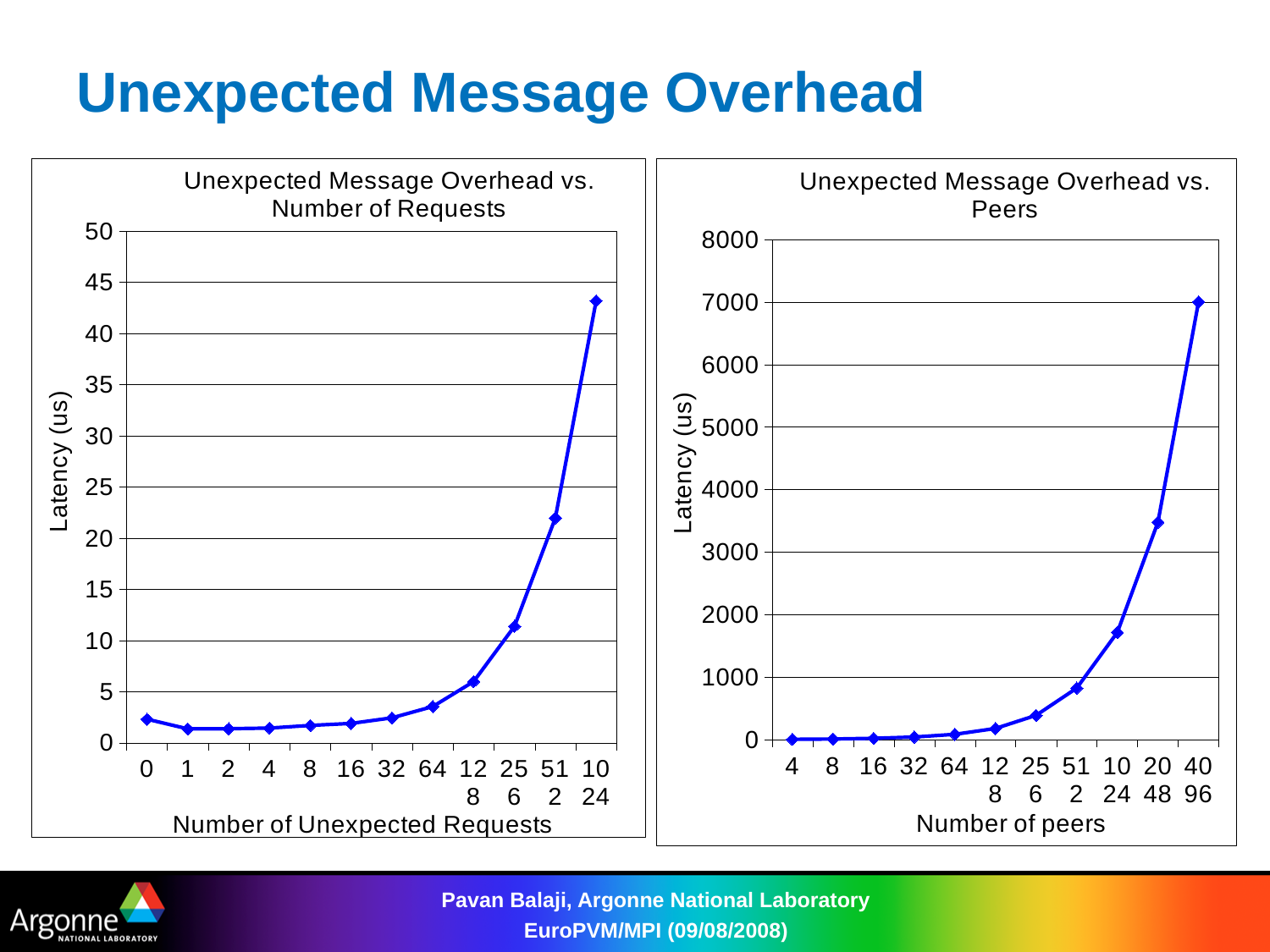
In the left chart, 'Unexpected Message Overhead vs. Number of Requests', is the latency at 512 unexpected requests larger or smaller than at 256? larger What kind of chart is the left chart, 'Unexpected Message Overhead vs. Number of Requests'? line chart In the left chart, 'Unexpected Message Overhead vs. Number of Requests', is the latency at 64 unexpected requests greater or less than 5? less In the left chart, 'Unexpected Message Overhead vs. Number of Requests', is the latency at 1024 unexpected requests greater or less than 40? greater In the right chart, 'Unexpected Message Overhead vs. Peers', how many data points are plotted? 11 What is the y-axis label of the right chart, 'Unexpected Message Overhead vs. Peers'? Latency (us) In the right chart, 'Unexpected Message Overhead vs. Peers', does latency rise or fall as the number of peers increases? rises In the right chart, 'Unexpected Message Overhead vs. Peers', is the latency at 2048 peers greater or less than 3000? greater In the right chart, 'Unexpected Message Overhead vs. Peers', which number of peers has the highest latency? 4096 In the left chart, 'Unexpected Message Overhead vs. Number of Requests', which number of unexpected requests has the highest latency? 1024 In the left chart, 'Unexpected Message Overhead vs. Number of Requests', how many data points are plotted? 12